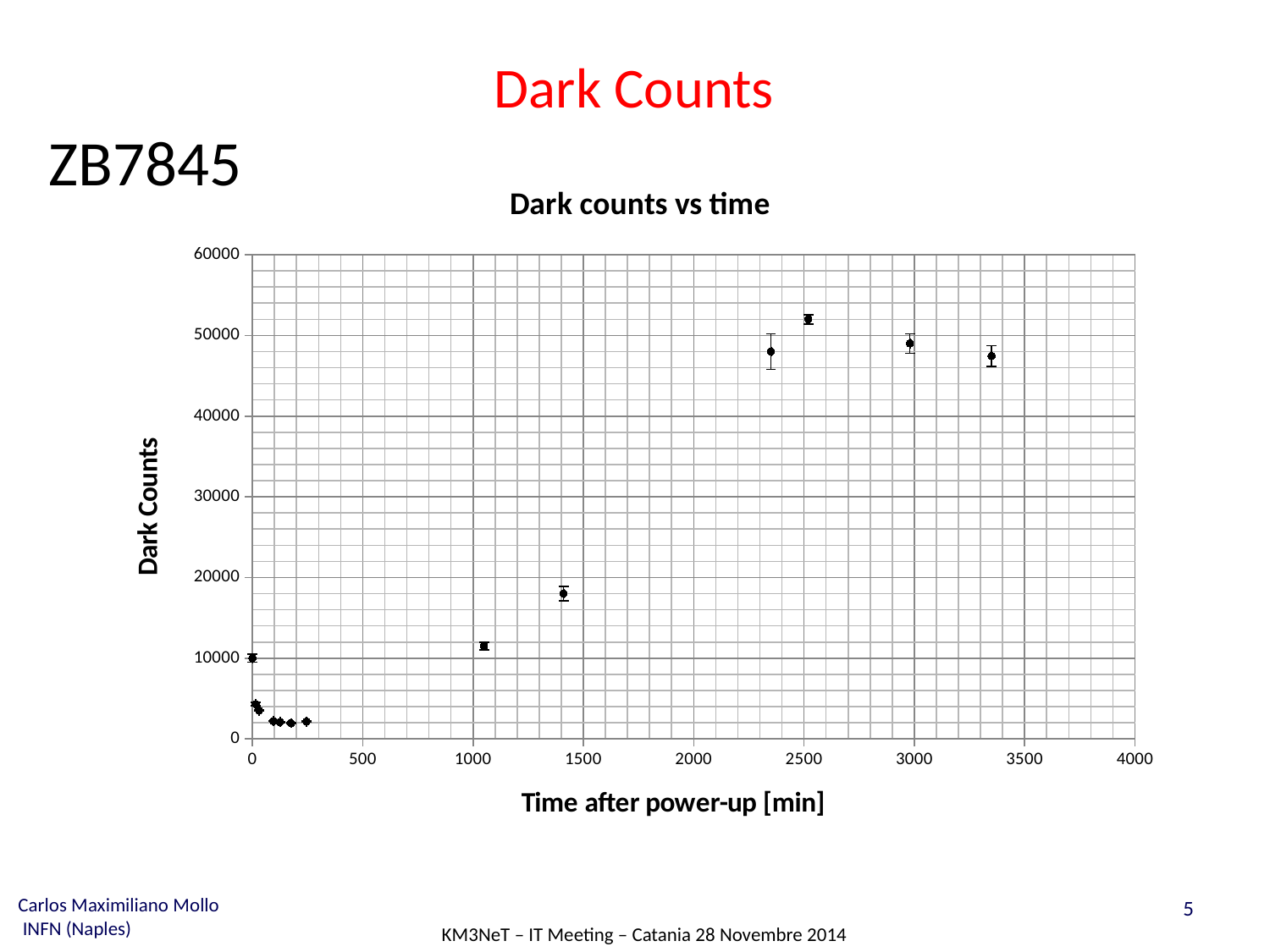
Is the dark count value at about 3350 minutes after power-up greater or less than 50000? less What kind of chart is shown on the slide? scatter chart What is the title of the chart? Dark counts vs time Is the dark count value at about 1050 minutes after power-up greater or less than 10000? greater Which has the higher dark count: the point at about 2500 minutes or the point at about 3350 minutes? the point at about 2500 minutes Which has the higher dark count: the point at about 1050 minutes or the point at about 1400 minutes? the point at about 1400 minutes Is the dark count value at about 2500 minutes after power-up greater or less than 50000? greater Between about 1000 and 2500 minutes after power-up, do the dark counts rise or fall? rise What is the label of the x axis of the chart? Time after power-up [min]